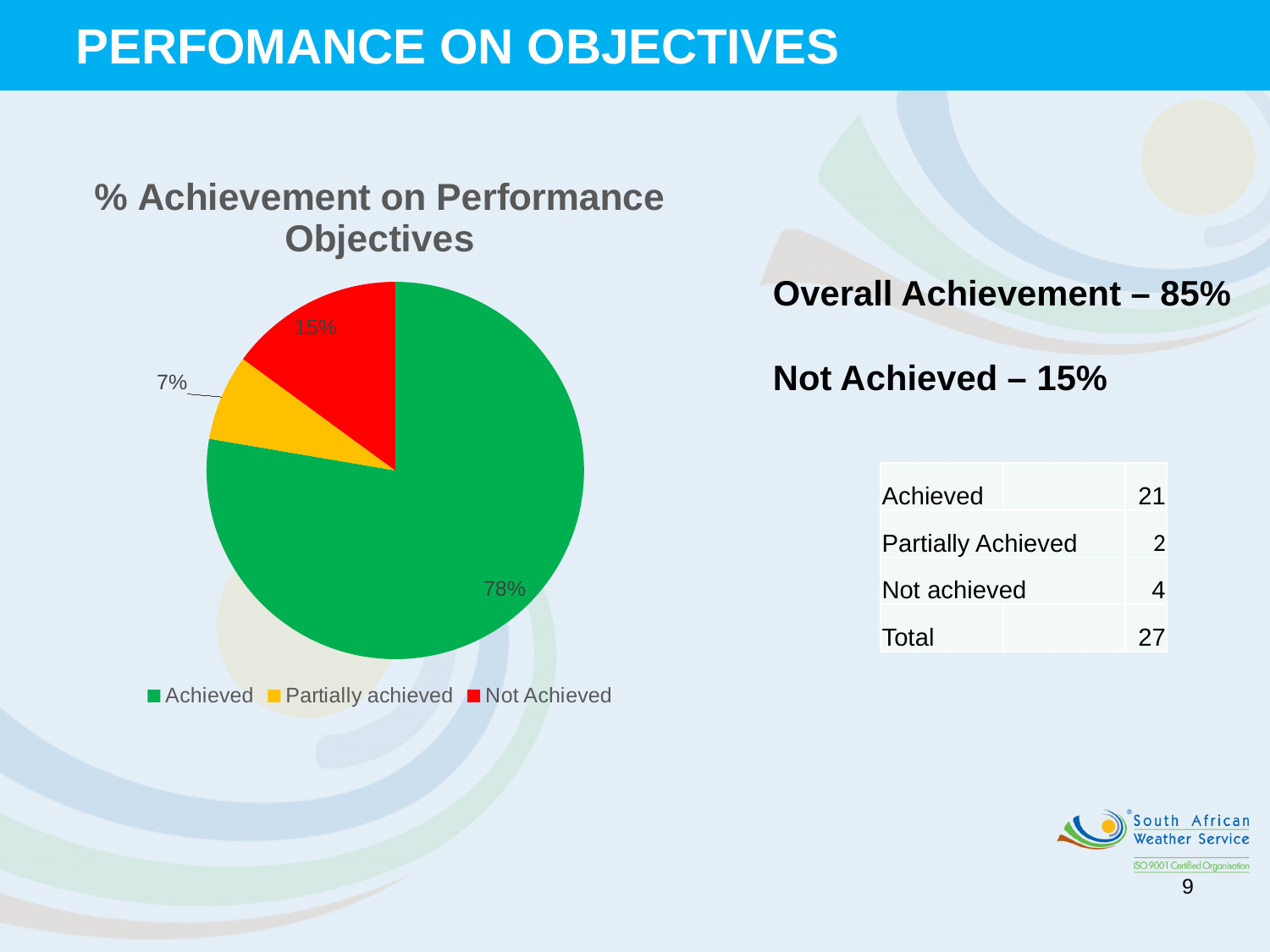
How many entries does the legend list? 3 Which slice is larger, Not Achieved or Partially achieved? Not Achieved What percentage of the pie is labelled for Partially achieved? 7% What percentage of the pie is labelled for Not Achieved? 15% What colour is the Achieved slice in the pie chart? Green Which category has the largest slice of the pie? Achieved What type of chart is shown on the slide? Pie chart What is the title of the chart? % Achievement on Performance Objectives How many slices does the pie chart have? 3 What percentage of the pie is labelled for Achieved? 78% What is the difference in percentage points between the Achieved slice and the Not Achieved slice? 63 Which category has the smallest slice of the pie? Partially achieved